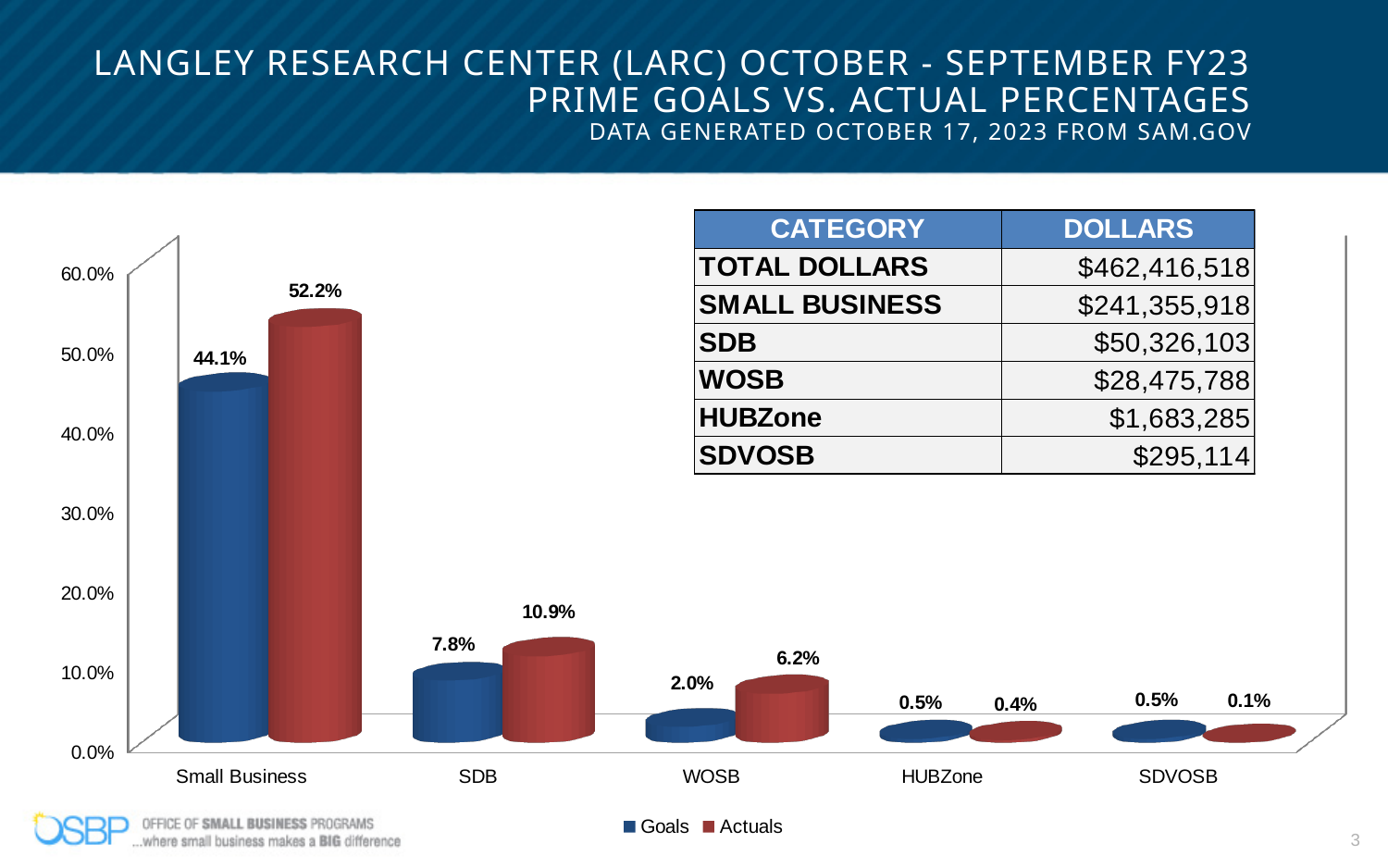
What is the Goals value for HUBZone? 0.5% What is the Actuals value for WOSB? 6.2% What is the difference between the Actuals and Goals values for Small Business? 8.1% Which category has the lowest Actuals value? SDVOSB Which is larger for SDVOSB, the Goals value or the Actuals value? Goals How many categories are shown on the x axis of the chart? 5 Is the Goals value for Small Business greater or less than 40.0%? greater What is the Goals value for SDB? 7.8% How many series does the chart legend list? 2 What is the Actuals value for Small Business? 52.2% What kind of chart is shown on the slide? Bar chart Which category has the highest Actuals value? Small Business